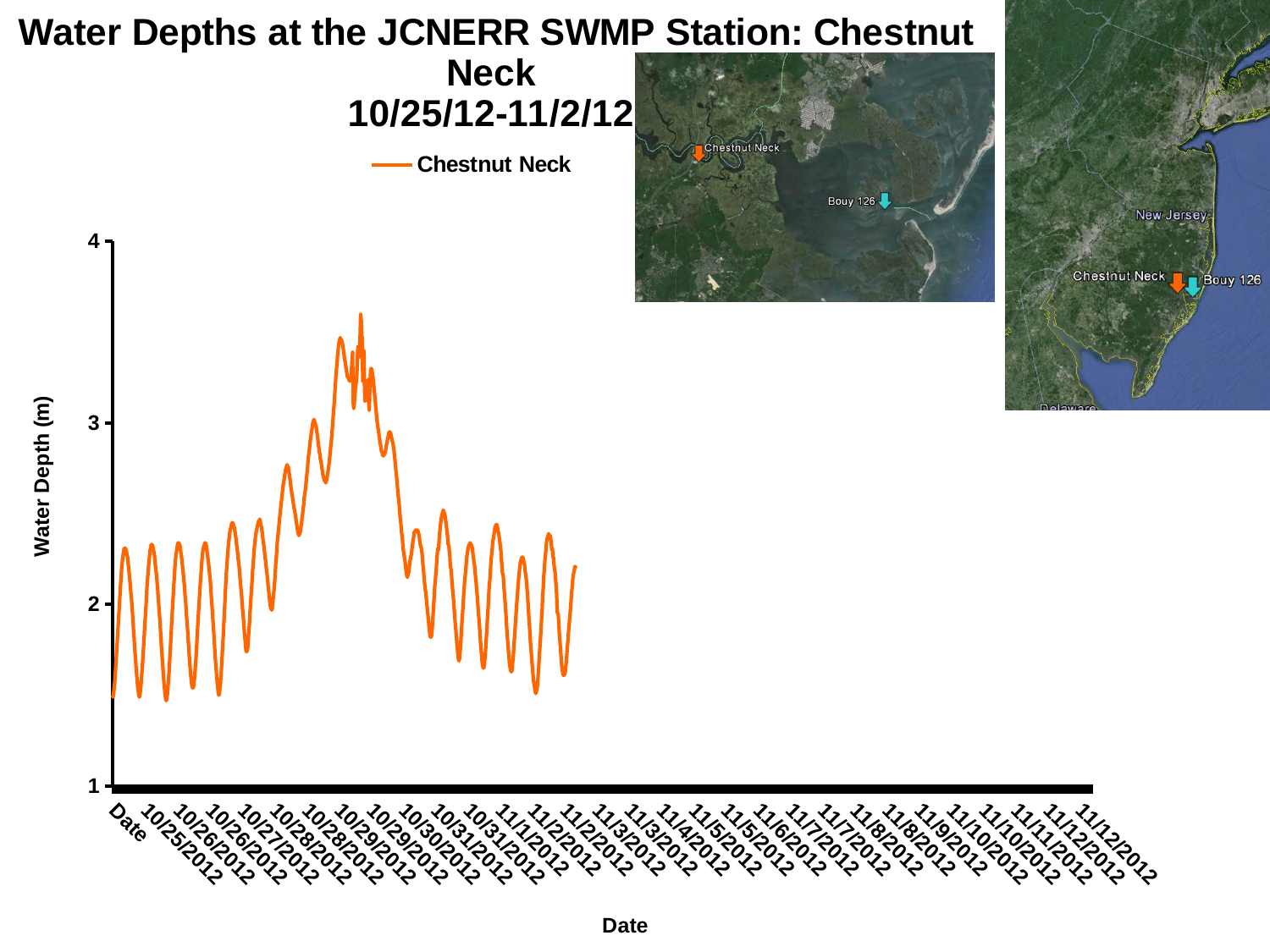
Is the lowest water depth reached in the chart greater or less than 1? greater How many series does the chart legend list? 1 What kind of chart is shown on the slide? line chart What is the label of the vertical axis of the chart? Water Depth (m) What is the name of the series shown in the chart legend? Chestnut Neck Is the water depth at the end of the plotted line (around 11/2/2012) greater or less than 3? less What is the highest value shown on the vertical axis of the chart? 4 Around which date does the water depth reach its maximum in the chart? 10/29/2012 Is the highest water depth reached in the chart greater or less than 4? less